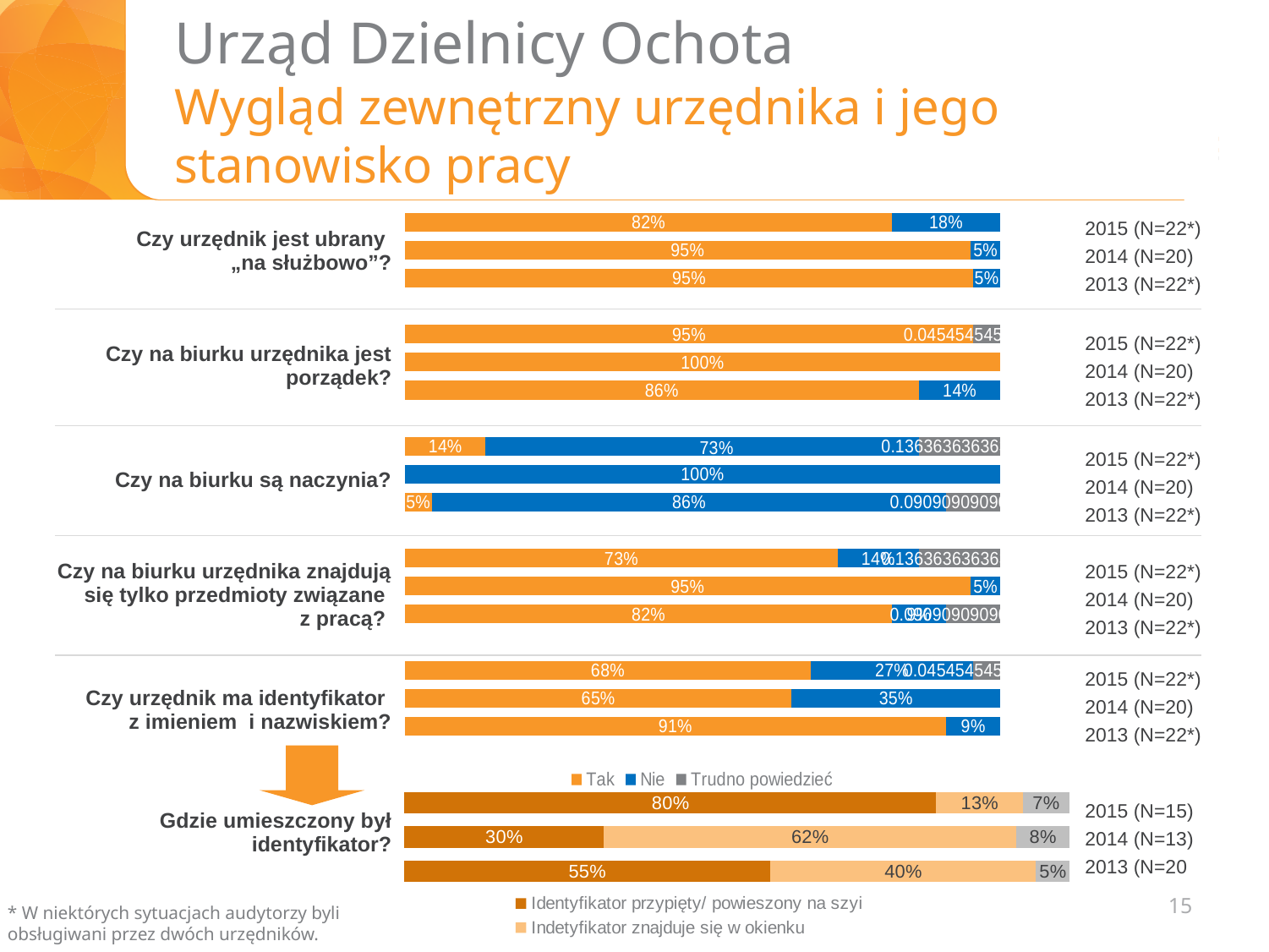
In the chart for "Czy na biurku są naczynia?", what is the "Nie" value for 2015 (N=22*)? 73% In the chart for "Czy na biurku urzędnika jest porządek?", what is the "Tak" value for 2014 (N=20)? 100% How many series does the legend above the "Gdzie umieszczony był identyfikator?" chart list (Tak / Nie / Trudno powiedzieć)? 3 In the chart for "Czy na biurku urzędnika jest porządek?", which year has the lowest "Tak" value? 2013 (N=22*) In the chart for "Czy urzędnik ma identyfikator z imieniem i nazwiskiem?", which year has the highest "Nie" value? 2014 (N=20) In the chart for "Czy urzędnik jest ubrany „na służbowo”?", what percentage answered "Tak" in 2015 (N=22*)? 82% In the chart for "Czy urzędnik jest ubrany „na służbowo”?", what is the "Nie" value for 2015 (N=22*)? 18% In the chart for "Czy na biurku są naczynia?", what is the "Tak" value for 2013 (N=22*)? 5% In the chart for "Gdzie umieszczony był identyfikator?", is the value for "Indetyfikator znajduje się w okienku" larger in 2014 (N=13) or 2013 (N=20)? 2014 (N=13) In the chart for "Gdzie umieszczony był identyfikator?", what is the value for "Identyfikator przypięty/ powieszony na szyi" in 2014 (N=13)? 30% In the chart for "Czy urzędnik ma identyfikator z imieniem i nazwiskiem?", what is the difference between the "Tak" values for 2013 (N=22*) and 2014 (N=20)? 26% What type of chart is used for "Czy na biurku urzędnika znajdują się tylko przedmioty związane z pracą?"? Stacked bar chart